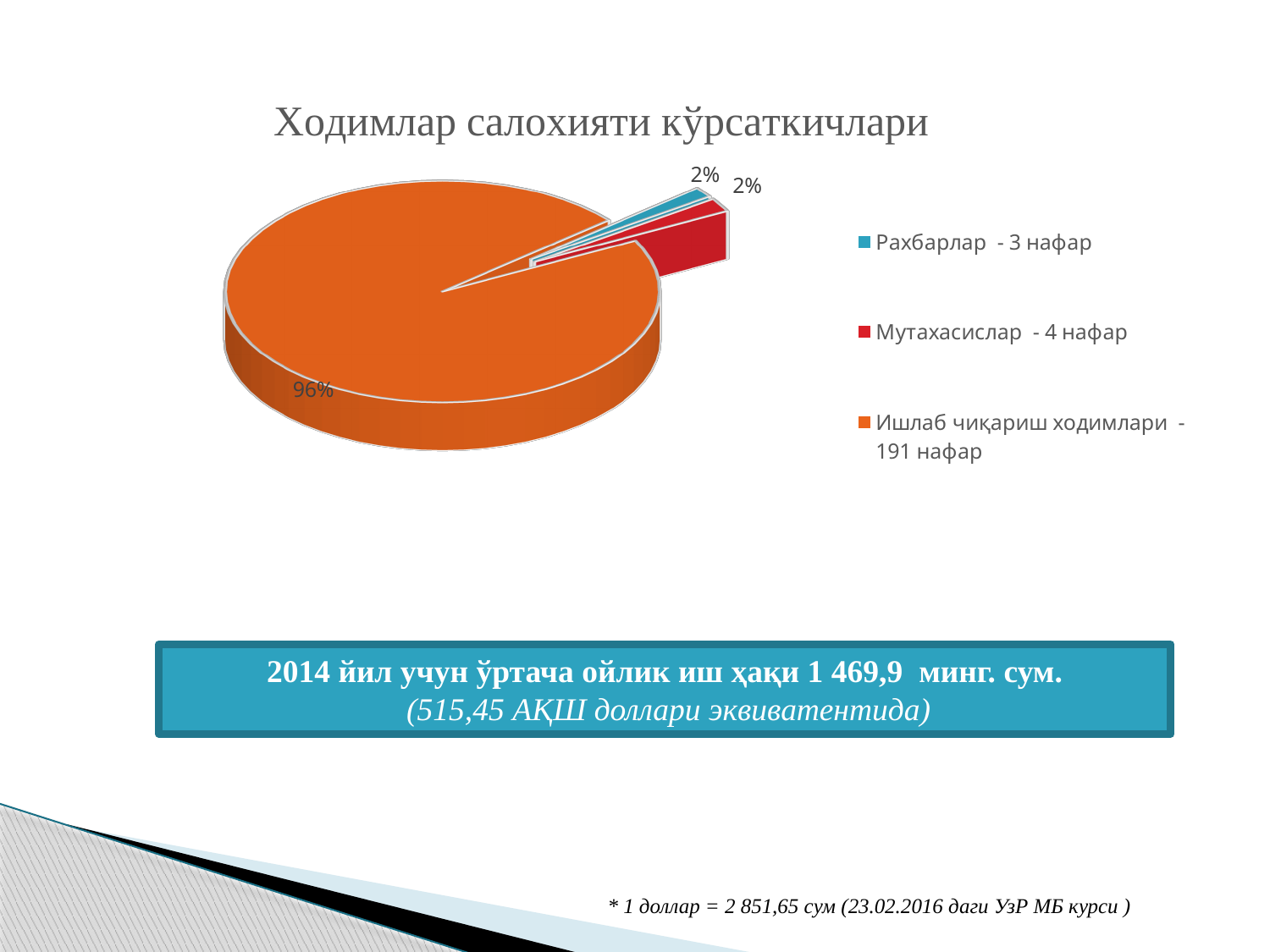
Which category has the largest slice of the pie? Ишлаб чиқариш ходимлари - 191 нафар What share of the pie is labelled for Мутахасислар - 4 нафар? 2% What is the title of the chart? Ходимлар салохияти кўрсаткичлари What is the difference in percentage points between the Ишлаб чиқариш ходимлари slice and the Рахбарлар slice? 94 How many slices does the pie chart have? 3 What share of the pie is labelled for Ишлаб чиқариш ходимлари - 191 нафар? 96% Is the share for Ишлаб чиқариш ходимлари greater or less than 50%? greater What colour is the slice for Рахбарлар - 3 нафар? blue Which is larger: the slice for Ишлаб чиқариш ходимлари or the slice for Мутахасислар? Ишлаб чиқариш ходимлари What kind of chart is shown on the slide? pie chart What share of the pie is labelled for Рахбарлар - 3 нафар? 2% How many entries does the legend list? 3